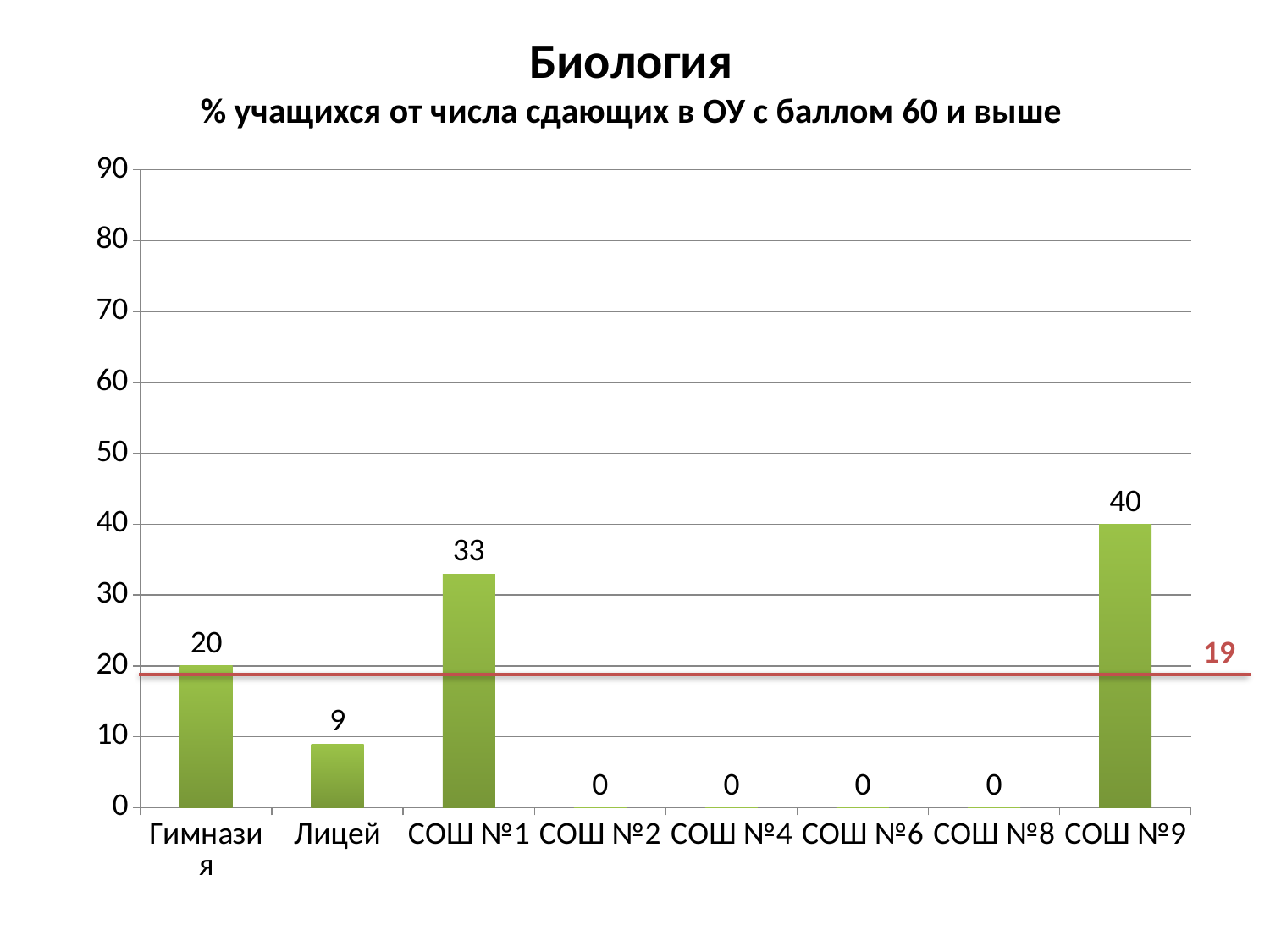
What value is marked by the red horizontal line? 19 How many categories are shown on the x axis? 8 What is the value for СОШ №1? 33 What is the difference between the values for СОШ №9 and СОШ №1? 7 What is the value for Гимназия? 20 What is the title of the chart? Биология How many categories have a value of 0? 4 What is the value for Лицей? 9 Which category has the highest value? СОШ №9 What kind of chart is shown? bar chart What is the value for СОШ №9? 40 Which is larger, the value for Гимназия or the value for Лицей? Гимназия